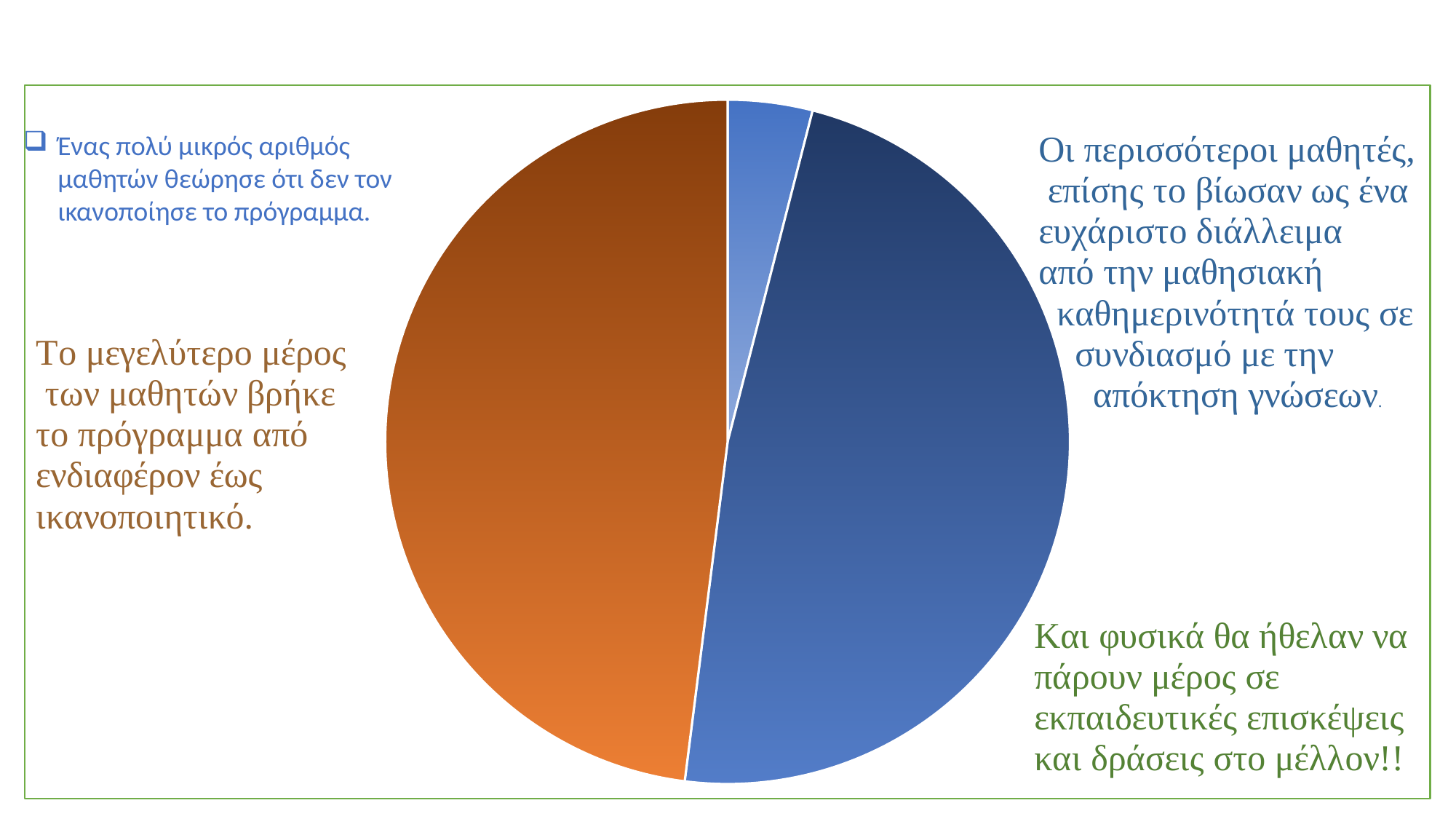
Which colour is the smallest slice of the pie chart? light blue Does the pie chart display a legend? No Which slice is larger, the light blue slice or the dark blue slice? dark blue Which slice is larger, the orange slice or the light blue slice? orange Are any data labels printed on the pie chart slices? No What kind of chart is shown on the slide? pie chart How many slices does the pie chart have? 3